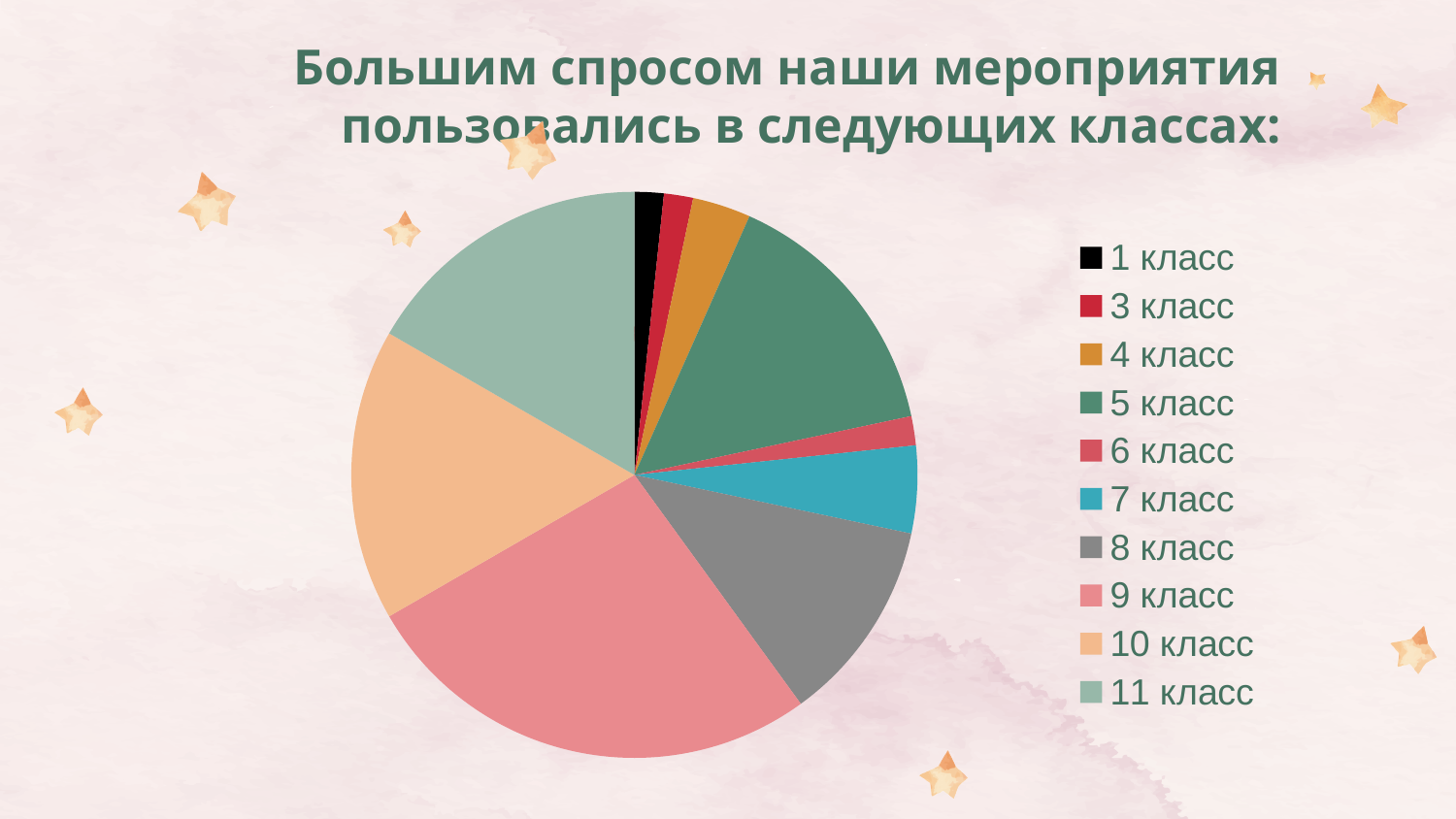
Which class has the largest slice of the pie? 9 класс What is the title of the slide above the chart? Большим спросом наши мероприятия пользовались в следующих классах: Which slice is larger, 11 класс or 8 класс? 11 класс Which slice is larger, 4 класс or 10 класс? 10 класс How many classes (slices) does the pie chart show? 10 How many entries does the legend list? 10 What colour is the slice for 1 класс? Black What kind of chart is shown on the slide? Pie chart Which slice is larger, 8 класс or 6 класс? 8 класс